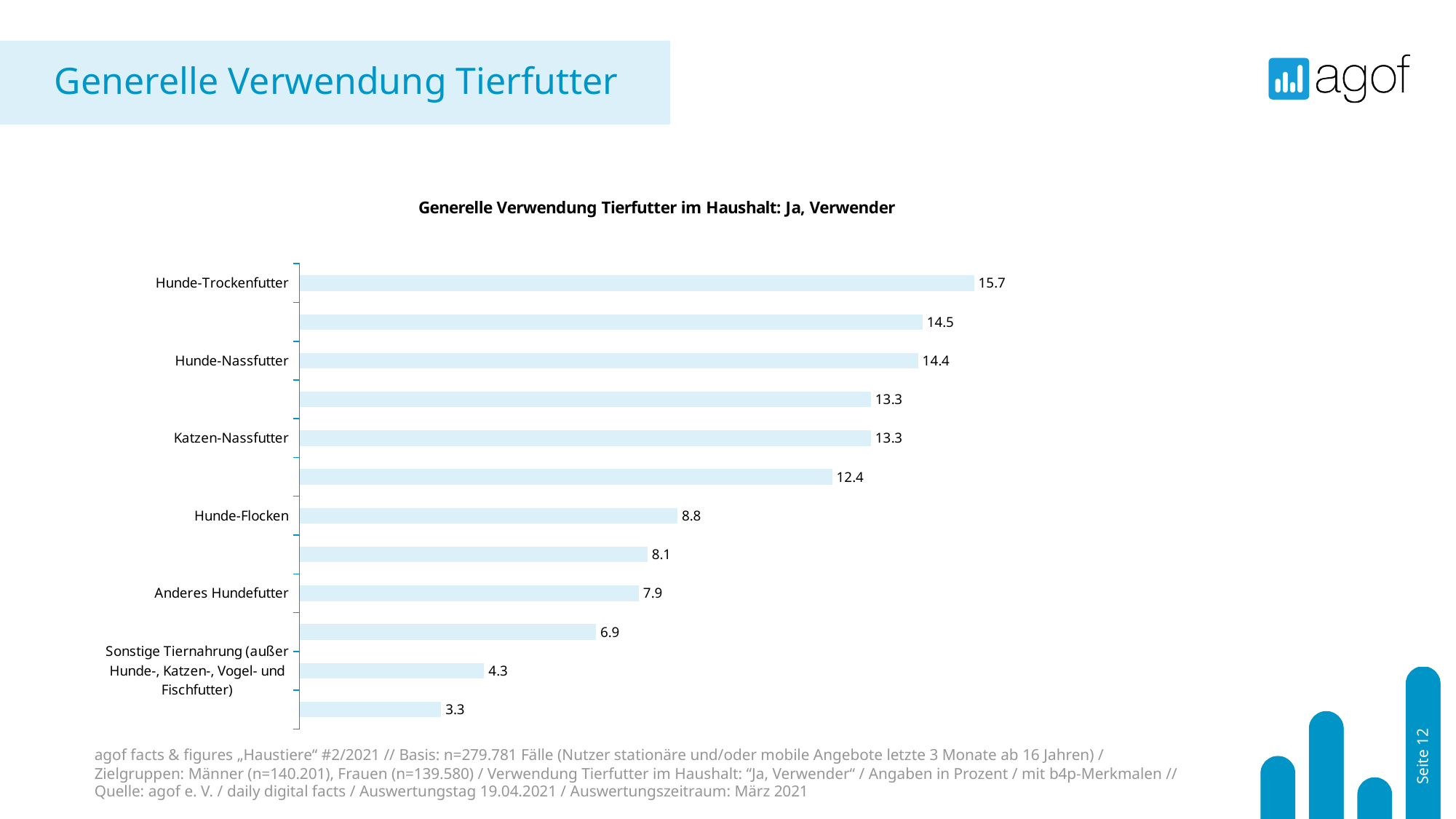
What is the value for Hunde-Flocken? 8.8 What is the value for Katzen-Nassfutter? 13.3 What type of chart is shown on the slide? Bar chart What is the value for Hunde-Trockenfutter? 15.7 What is the value for Hunde-Nassfutter? 14.4 Which is larger, the value for Hunde-Flocken or for Anderes Hundefutter? Hunde-Flocken Which category has the highest value? Hunde-Trockenfutter What is the value for Anderes Hundefutter? 7.9 What is the value for Sonstige Tiernahrung (außer Hunde-, Katzen-, Vogel- und Fischfutter)? 4.3 What is the difference between the values for Hunde-Trockenfutter and Hunde-Nassfutter? 1.3 How many bars are shown in the chart? 12 What is the lowest value shown in the chart? 3.3